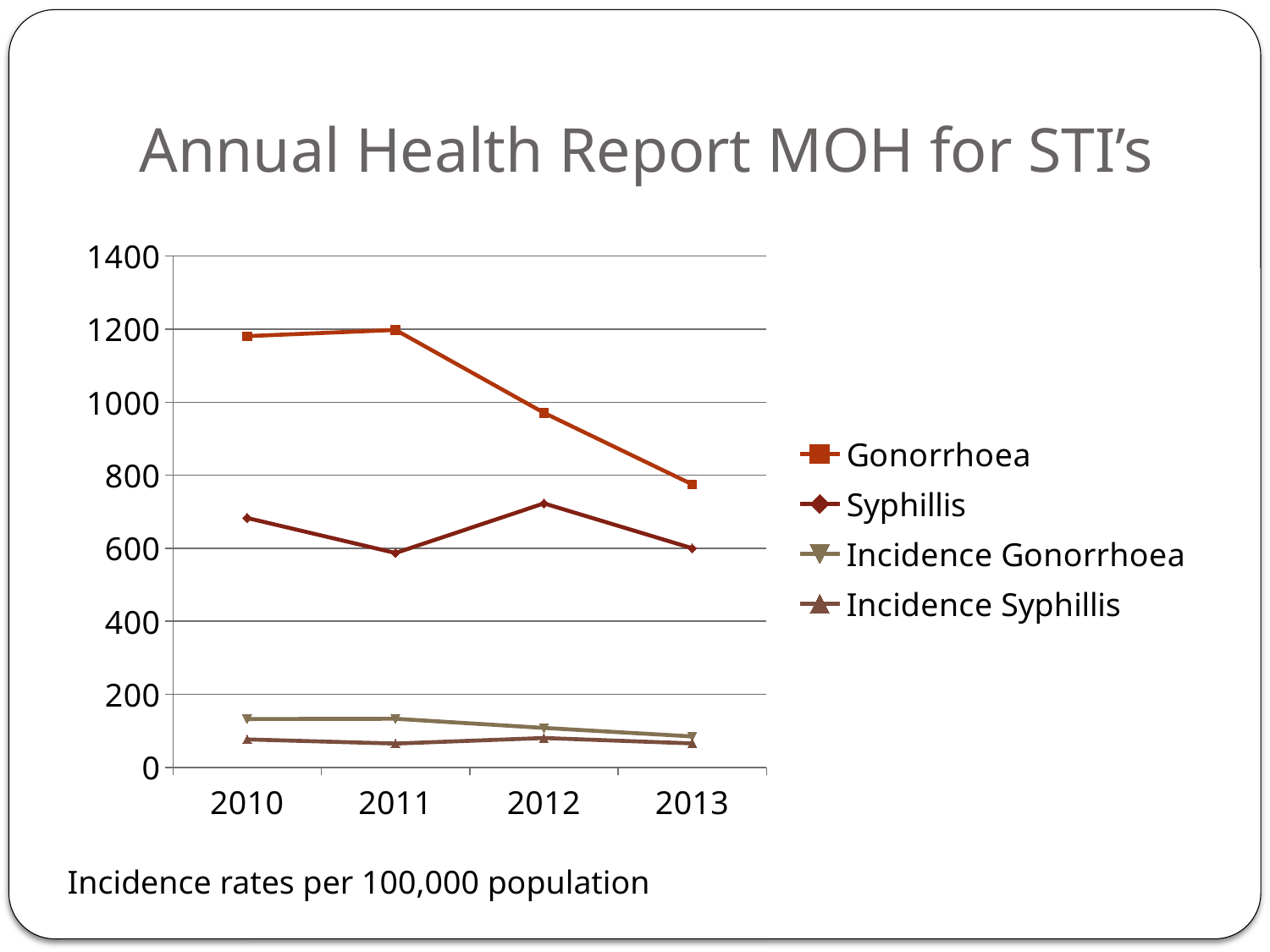
In which year is the Syphillis series at its highest? 2012 What is the title of the slide? Annual Health Report MOH for STI's Is the Gonorrhoea value for 2013 greater or less than 800? less How many years are plotted along the x axis? 4 In 2010, which is larger: the Gonorrhoea value or the Syphillis value? Gonorrhoea How many series does the legend list? 4 Is the Gonorrhoea value for 2012 greater or less than 1000? less What kind of chart is shown on the slide? line chart Is the Incidence Gonorrhoea value for 2010 greater or less than 200? less Does the Gonorrhoea series rise or fall from 2011 to 2013? fall In which year is the Gonorrhoea series at its lowest? 2013